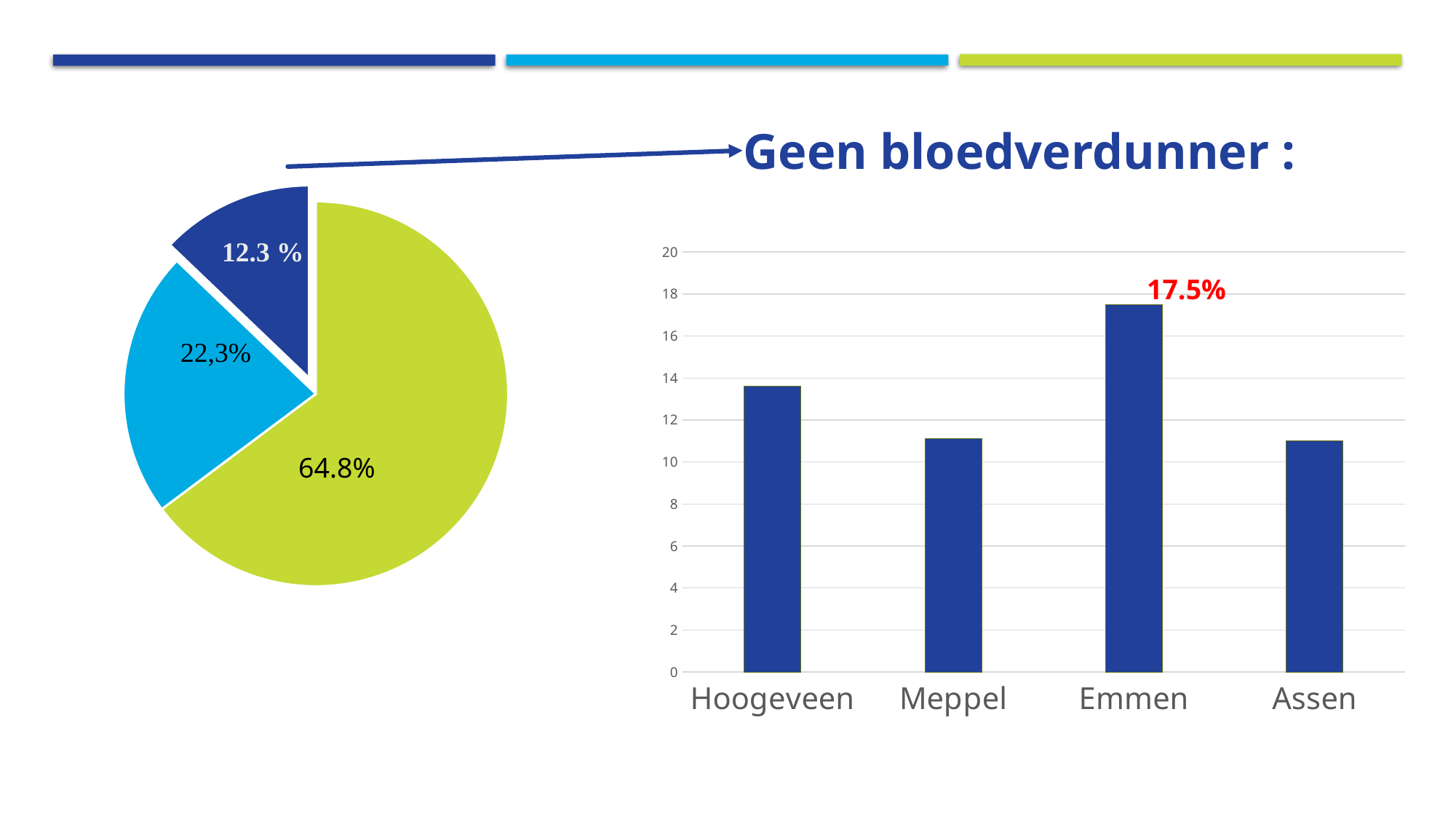
On the bar chart titled "Geen bloedverdunner", what is the value for Emmen? 17.5% On the bar chart titled "Geen bloedverdunner", which category has the highest value? Emmen What kind of chart is the chart on the right side of the slide? bar chart On the bar chart titled "Geen bloedverdunner", is the value for Assen greater or less than 12? less On the pie chart on the left, what is the share of the largest slice? 64.8% On the bar chart titled "Geen bloedverdunner", which is larger, the value for Emmen or the value for Assen? Emmen On the bar chart titled "Geen bloedverdunner", how many categories are shown on the x axis? 4 On the bar chart titled "Geen bloedverdunner", is the value for Meppel greater or less than 12? less On the pie chart on the left, how many slices are there? 3 On the bar chart titled "Geen bloedverdunner", is the value for Hoogeveen greater or less than 12? greater What kind of chart is the chart on the left side of the slide? pie chart On the bar chart titled "Geen bloedverdunner", which is larger, the value for Hoogeveen or the value for Meppel? Hoogeveen